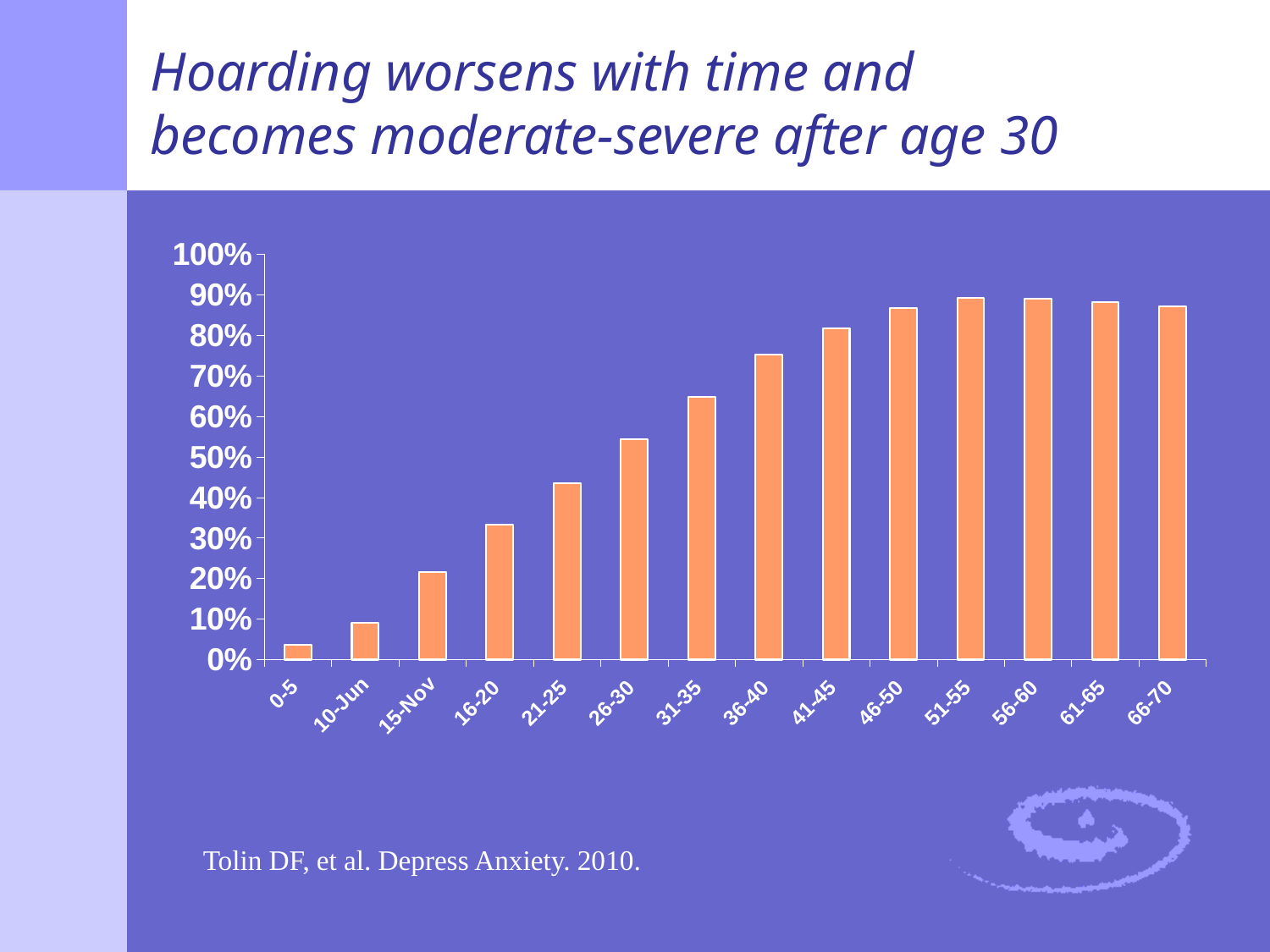
How many age-group categories are plotted on the x axis? 14 Which is larger, the value for 21-25 or the value for 36-40? 36-40 Do the values generally rise or fall as age increases along the x axis? rise What kind of chart is shown on the slide? bar chart What is the highest tick value shown on the y axis? 100% Is the value for the 16-20 age group greater or less than 30%? greater Is the value for the 0-5 age group greater or less than 10%? less Is the value for the 41-45 age group greater or less than 80%? greater Which age group has the lowest bar? 0-5